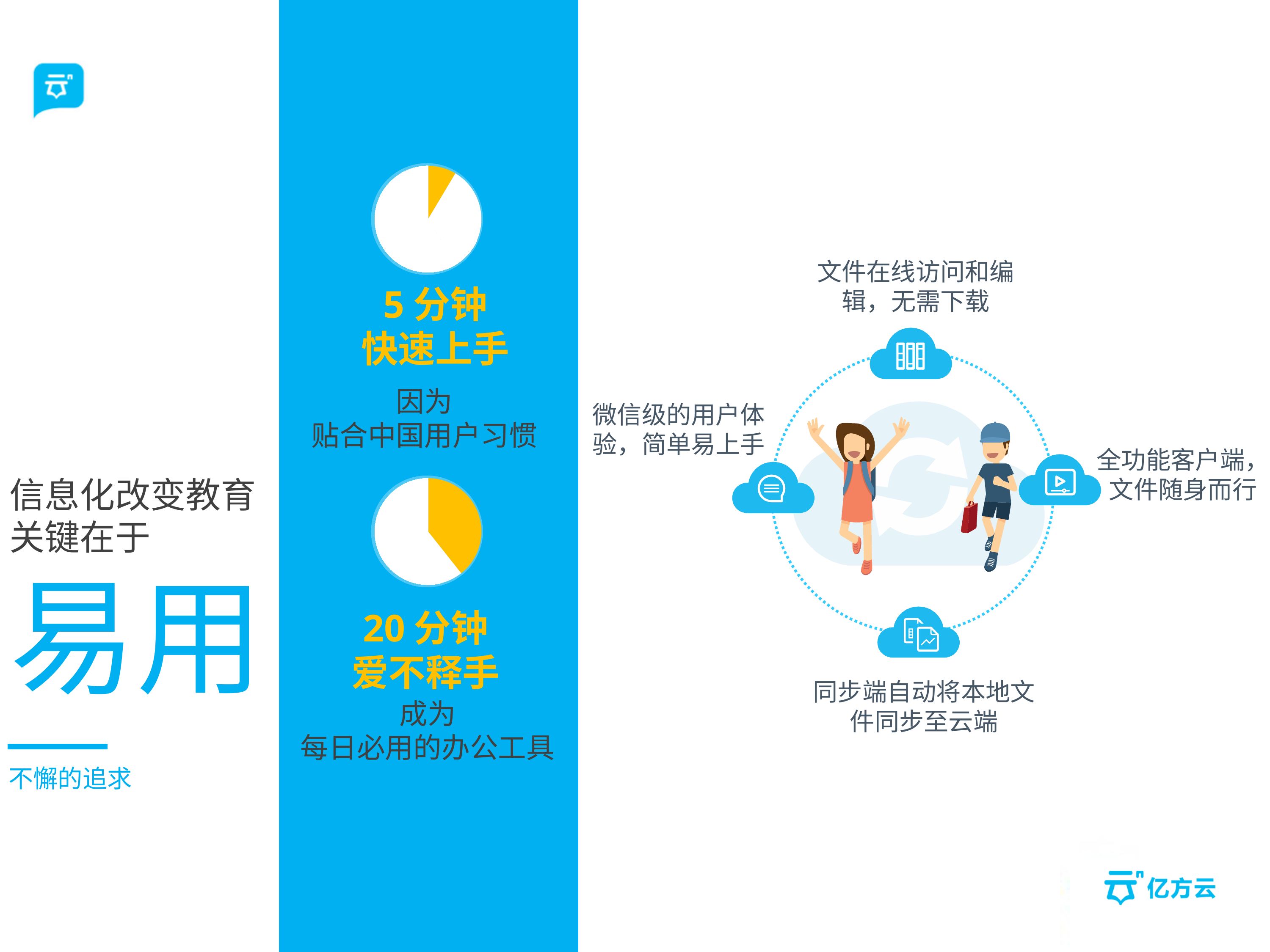
What phrase is printed in yellow under the '20 分钟' label of the lower pie chart? 爱不释手 Is the yellow slice of the upper pie chart (5 分钟) greater or less than half of the pie? less What colour is the remaining (non-highlighted) part of each pie chart? white What label is printed directly below the upper pie chart? 5 分钟 What colour is the highlighted slice in both pie charts? yellow What label is printed directly below the lower pie chart? 20 分钟 What phrase is printed in yellow under the '5 分钟' label of the upper pie chart? 快速上手 How many pie charts are shown on the slide? 2 What kind of chart is shown twice in the blue panel in the middle of the slide? pie chart Which pie chart has the larger yellow slice, the upper one (5 分钟) or the lower one (20 分钟)? the lower one (20 分钟) Which pie chart has the smaller yellow slice, the upper one (5 分钟) or the lower one (20 分钟)? the upper one (5 分钟) Is the yellow slice of the lower pie chart (20 分钟) greater or less than half of the pie? less